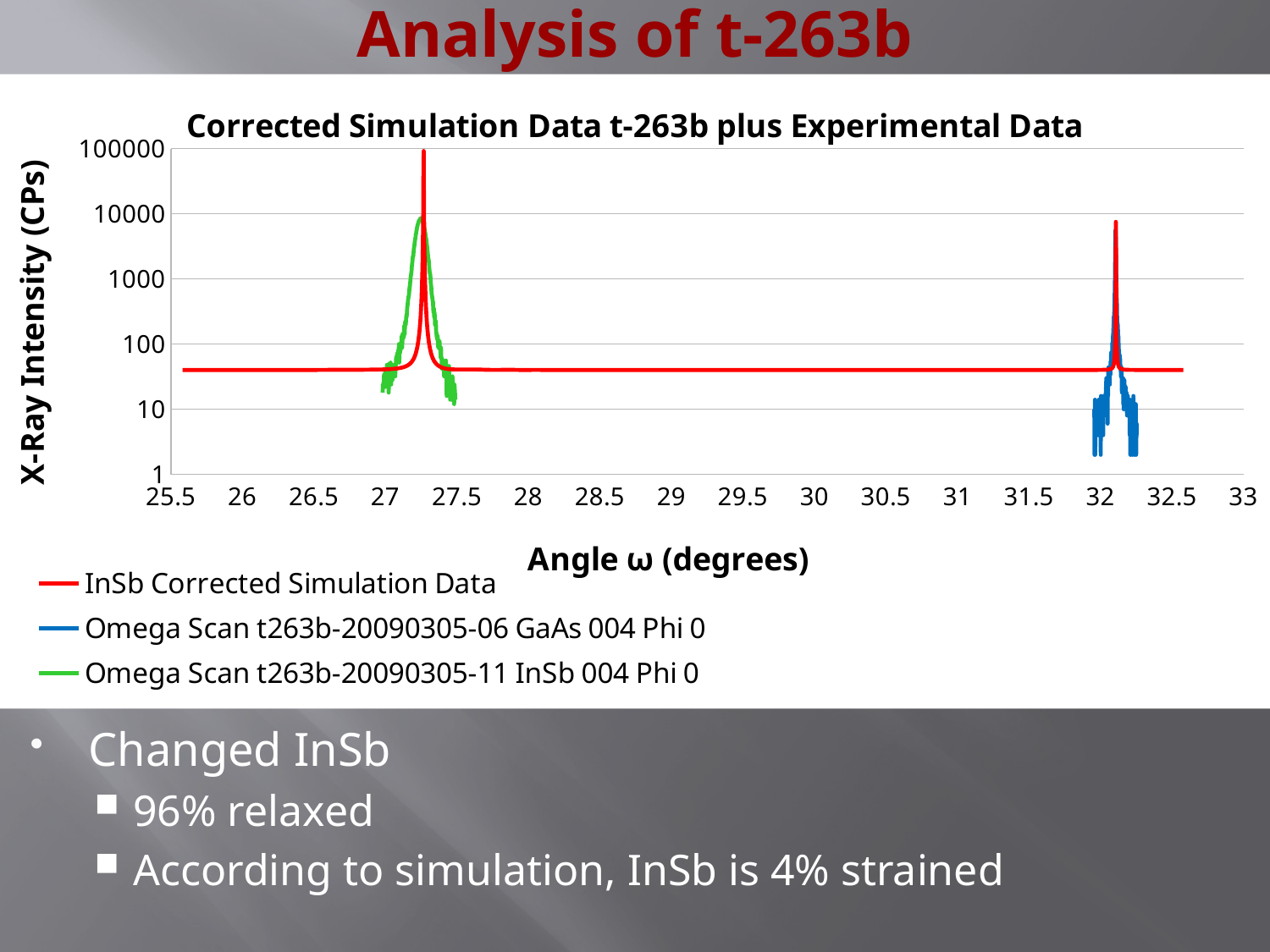
Is the flat baseline of the InSb Corrected Simulation Data line between 28 and 31 degrees greater or less than 100? less Which is higher: the InSb Corrected Simulation Data peak near 27.3 degrees or its peak near 32.1 degrees? the peak near 27.3 degrees What kind of chart is shown on the slide? line chart Which series drops to the lowest intensity values on the chart? Omega Scan t263b-20090305-06 GaAs 004 Phi 0 What is the label of the y axis? X-Ray Intensity (CPs) What is the title of the chart? Corrected Simulation Data t-263b plus Experimental Data What is the highest value shown on the y axis? 100000 Which series reaches the highest intensity on the chart? InSb Corrected Simulation Data How many peaks does the InSb Corrected Simulation Data line show? 2 Is the peak of the InSb Corrected Simulation Data line near 27.3 degrees greater or less than 10000? greater Is the peak of the Omega Scan t263b-20090305-06 GaAs 004 Phi 0 line near 32.1 degrees greater or less than 100? greater How many series does the chart legend list? 3